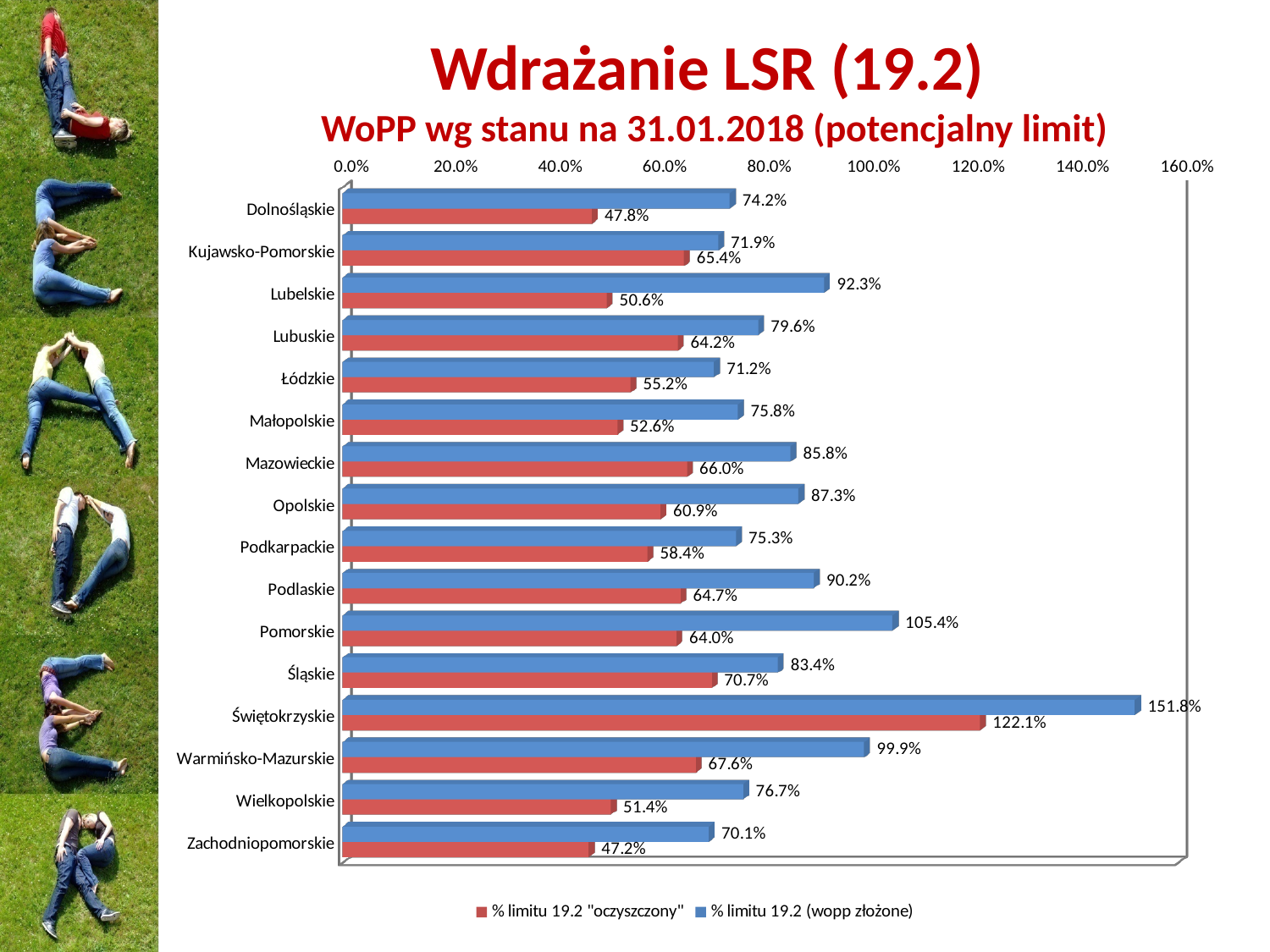
What is the value of "% limitu 19.2 (wopp złożone)" for Warmińsko-Mazurskie? 99.9% What is the difference between the "% limitu 19.2 (wopp złożone)" and "% limitu 19.2 "oczyszczony"" values for Świętokrzyskie? 29.7 percentage points Which voivodeship has the highest value of "% limitu 19.2 (wopp złożone)"? Świętokrzyskie Is the "% limitu 19.2 (wopp złożone)" value for Pomorskie greater or less than 100.0%? greater How many voivodeships are shown on the chart? 16 Which has a higher "% limitu 19.2 (wopp złożone)" value: Pomorskie or Warmińsko-Mazurskie? Pomorskie How many series does the legend list? 2 Which colour represents the series "% limitu 19.2 "oczyszczony""? Red Which voivodeship has the lowest value of "% limitu 19.2 (wopp złożone)"? Zachodniopomorskie What is the value of "% limitu 19.2 (wopp złożone)" for Pomorskie? 105.4% What is the value of "% limitu 19.2 "oczyszczony"" for Lubelskie? 50.6% What kind of chart is shown on the slide? Bar chart